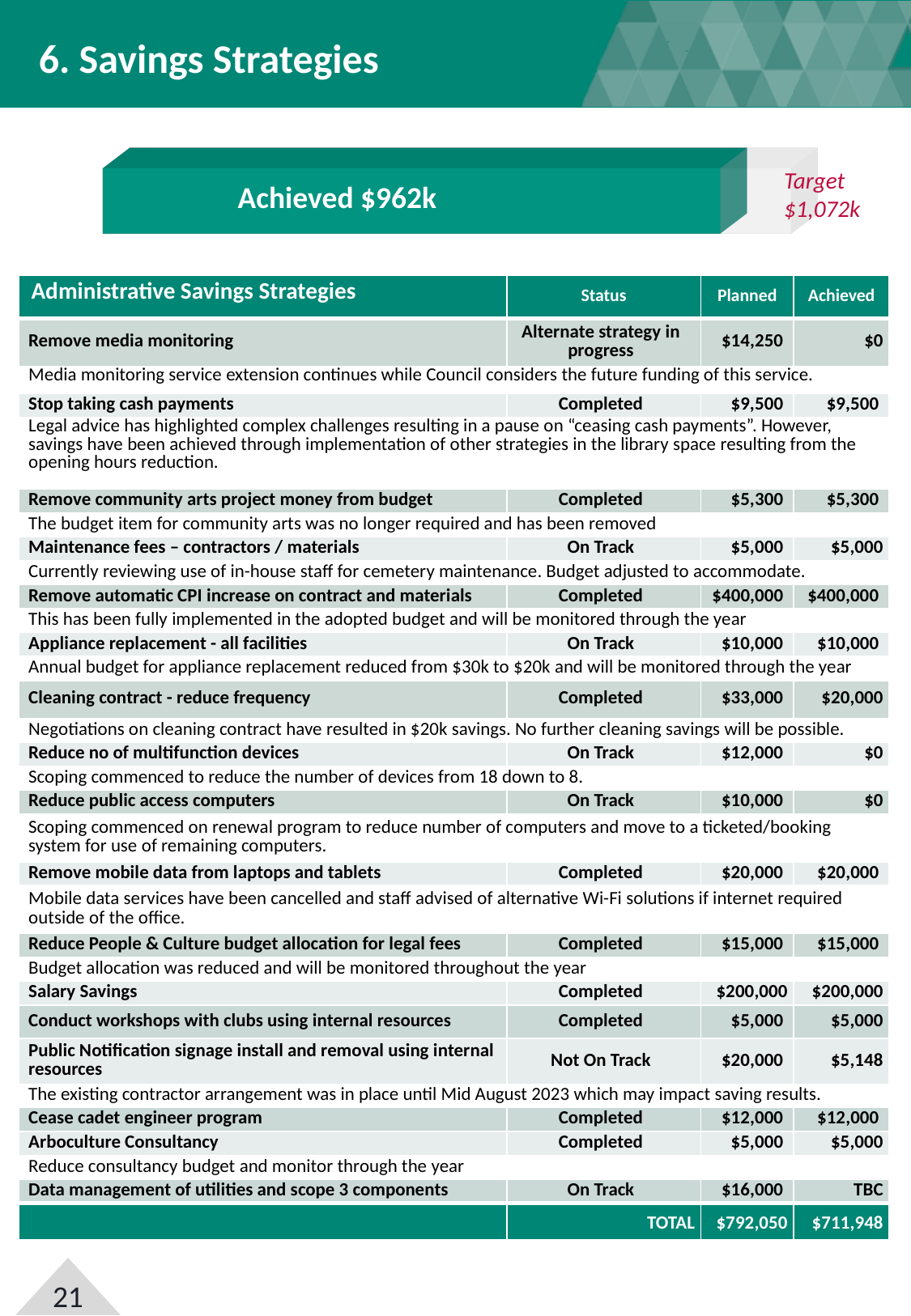
In the progress bar at the top of the slide, which is larger, the achieved amount or the target amount? Target In the progress bar at the top of the slide, is the achieved amount greater or less than $1,000k? less In the progress bar at the top of the slide, what savings amount is shown as achieved? $962k In the progress bar at the top of the slide, what is the target savings amount? $1,072k What kind of graphic is used at the top of the slide to show achieved savings against the target? Progress bar In the progress bar at the top of the slide, what is the difference between the target and the achieved amount? $110k In the progress bar at the top of the slide, what colour is the achieved portion? Teal green